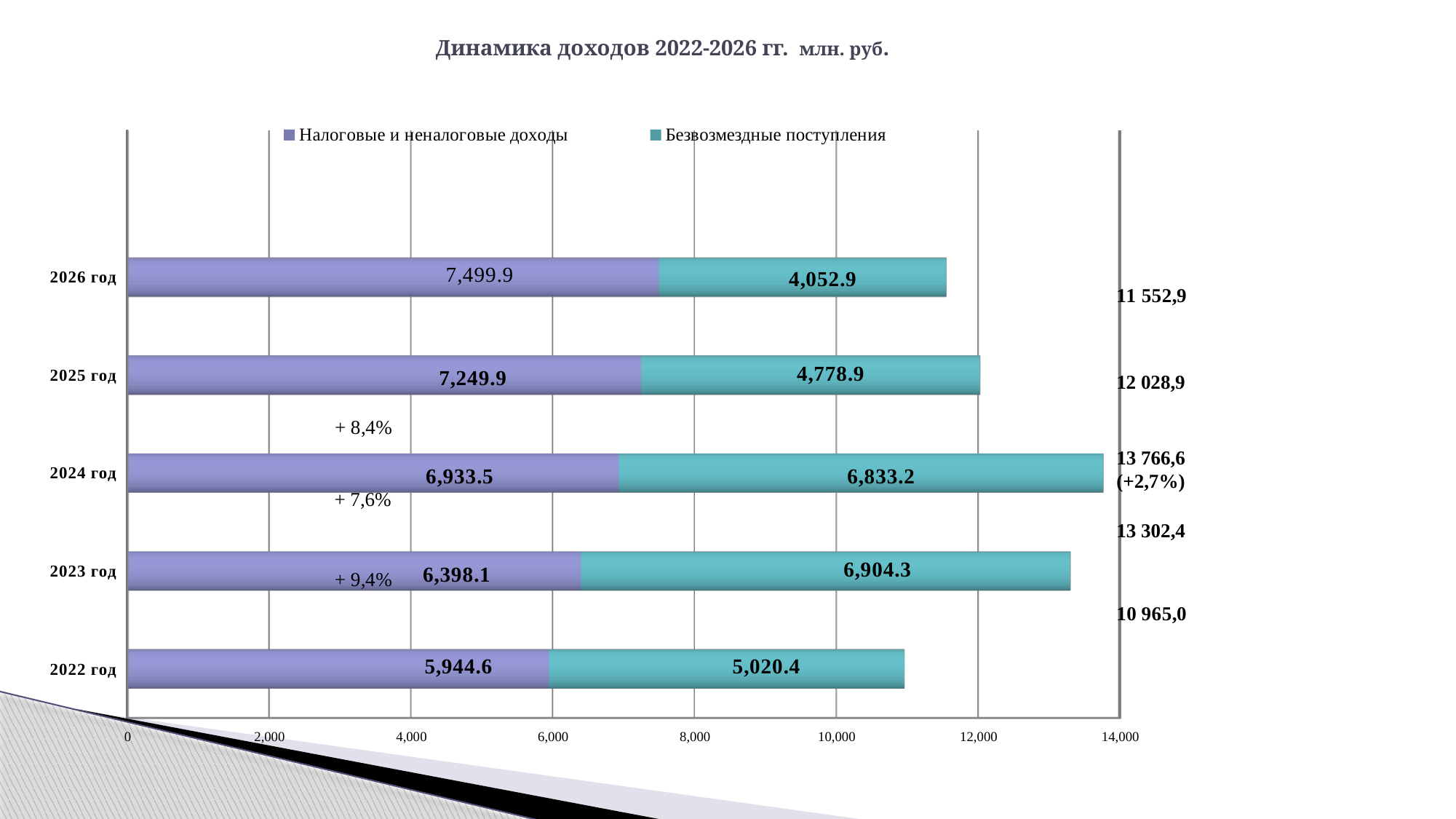
Which is larger in 2023 год: Налоговые и неналоговые доходы or Безвозмездные поступления? Безвозмездные поступления What is the total of the stacked bar for 2024 год? 13 766,6 What type of chart is shown on the slide? Stacked bar chart How many years are shown on the chart? 5 Which year has the highest value of Налоговые и неналоговые доходы? 2026 год Which year has the lowest value of Безвозмездные поступления? 2026 год How many series does the legend list? 2 What is the value of Налоговые и неналоговые доходы for 2022 год? 5,944.6 What is the value of Безвозмездные поступления for 2023 год? 6,904.3 What is the value of Налоговые и неналоговые доходы for 2024 год? 6,933.5 What is the difference between Налоговые и неналоговые доходы in 2026 год and 2025 год? 250.0 Do the values of Налоговые и неналоговые доходы rise or fall from 2022 год to 2026 год? Rise